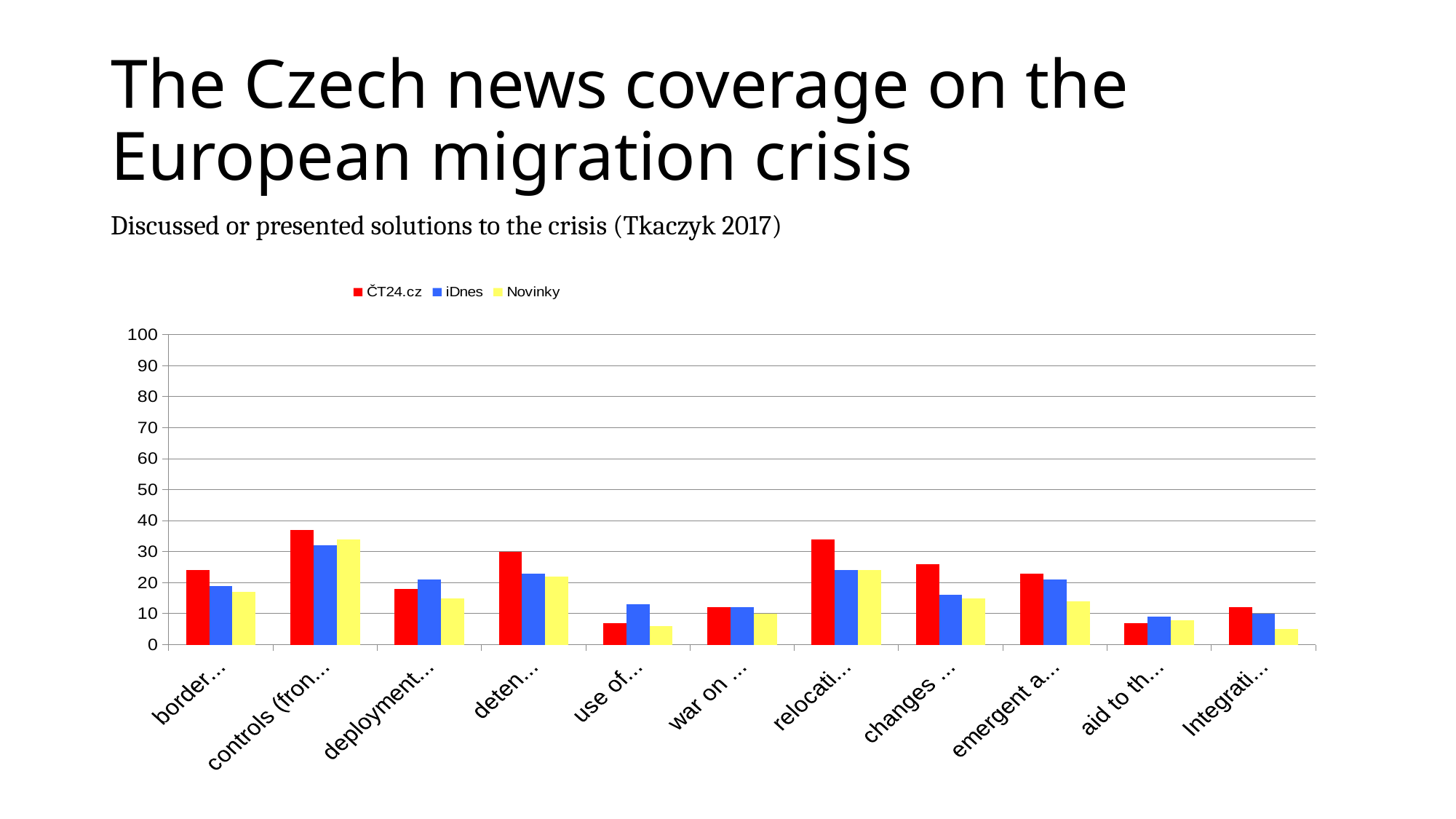
Which series has the lowest value for the category labelled 'emergent a…'? Novinky Is the ČT24.cz value for the category labelled 'controls (fron…' greater or less than 30? greater How many categories are shown along the x axis? 11 For the category labelled 'use of…', which is larger: the iDnes value or the ČT24.cz value? iDnes Is the Novinky value for the category labelled 'Integrati…' greater or less than 10? less Which series are listed in the legend? ČT24.cz, iDnes, Novinky Which series has the highest value for the category labelled 'relocati…'? ČT24.cz What kind of chart is shown on the slide? bar chart Is the ČT24.cz value for the category labelled 'deten…' greater or less than 20? greater What is the highest value shown on the y axis? 100 How many series does the legend list? 3